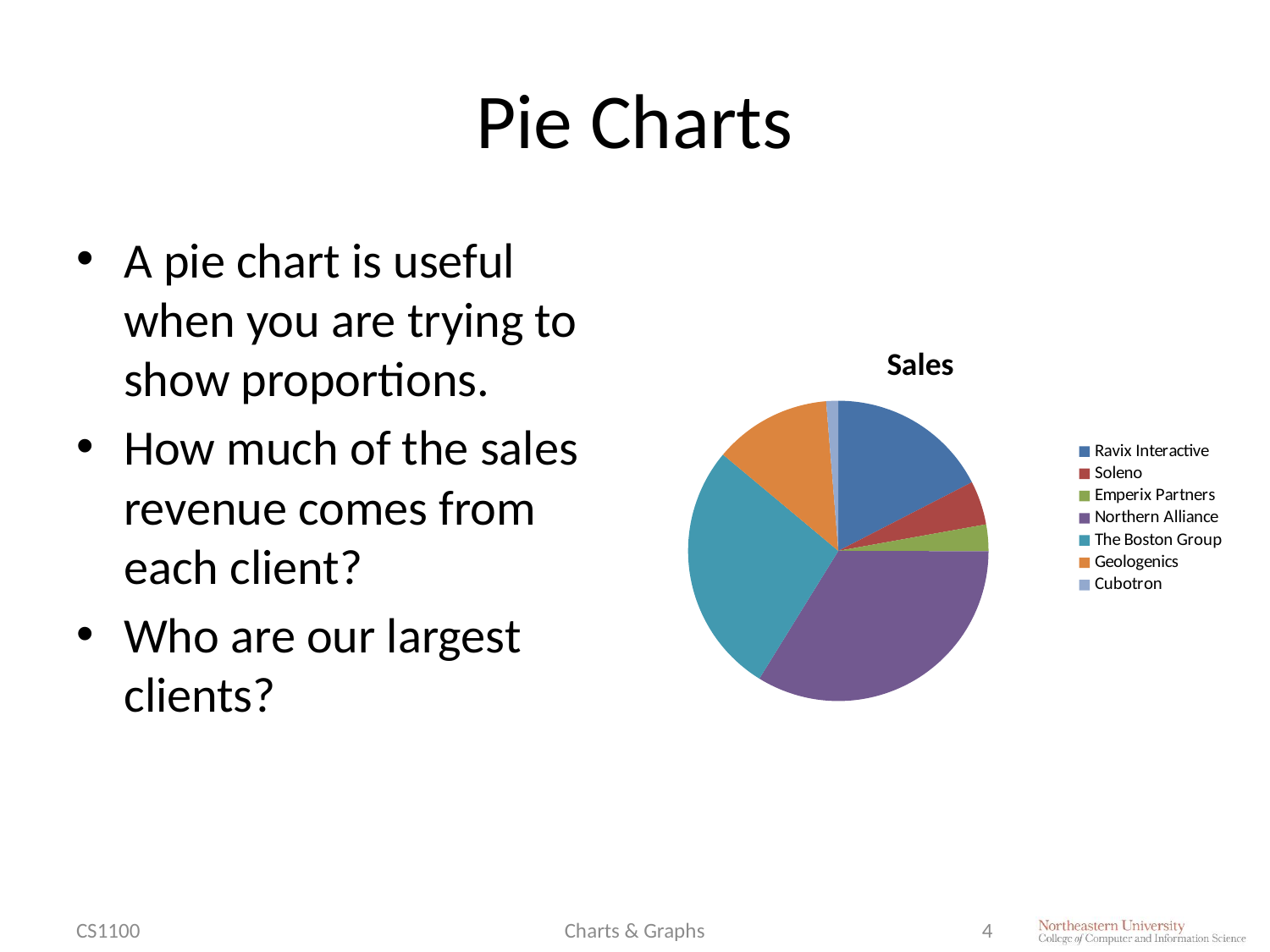
What is the title of the chart? Sales What kind of chart is shown on the slide? pie chart Which client has the largest slice of the pie? Northern Alliance What colour is the Northern Alliance slice? purple Which client is the second-largest slice of the pie? The Boston Group Which client has the smallest slice of the pie? Cubotron Which slice is larger, Soleno or Cubotron? Soleno Which slice is larger, Northern Alliance or The Boston Group? Northern Alliance How many slices does the pie chart have? 7 How many entries does the legend list? 7 Which slice is larger, The Boston Group or Ravix Interactive? The Boston Group